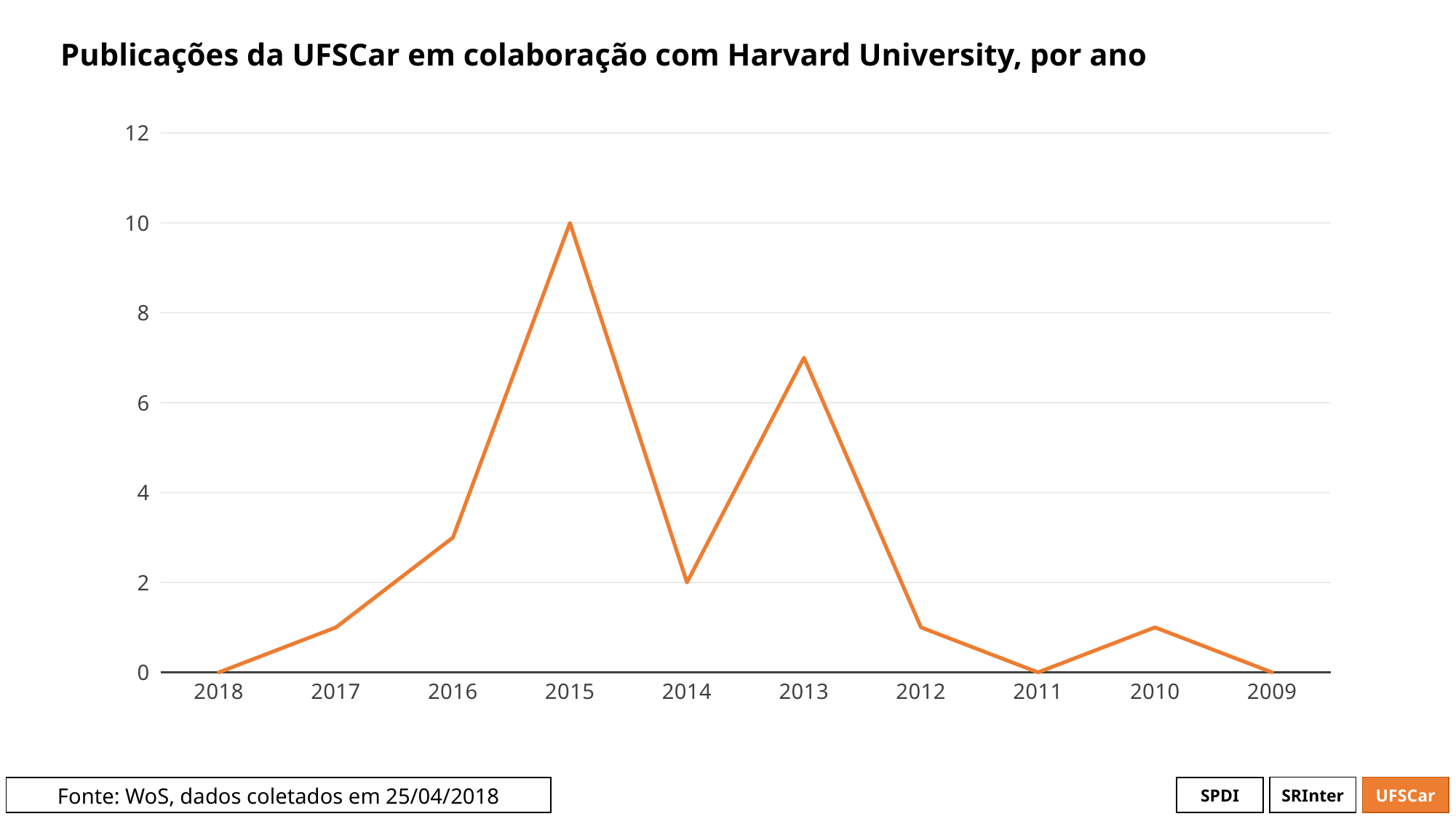
What is the title of the chart? Publicações da UFSCar em colaboração com Harvard University, por ano Do the values rise or fall from 2018 to 2015 along the x axis? rise What is the difference between the values for 2015 and 2014? 8 Which is larger, the value for 2015 or the value for 2013? 2015 What kind of chart is shown on the slide? line chart Is the value for 2013 greater or less than 6? greater What is the value for 2018? 0 How many years are plotted on the x axis? 10 Is the value for 2016 greater or less than 4? less Which year has the highest value? 2015 What is the value for 2014? 2 What is the value for 2015? 10